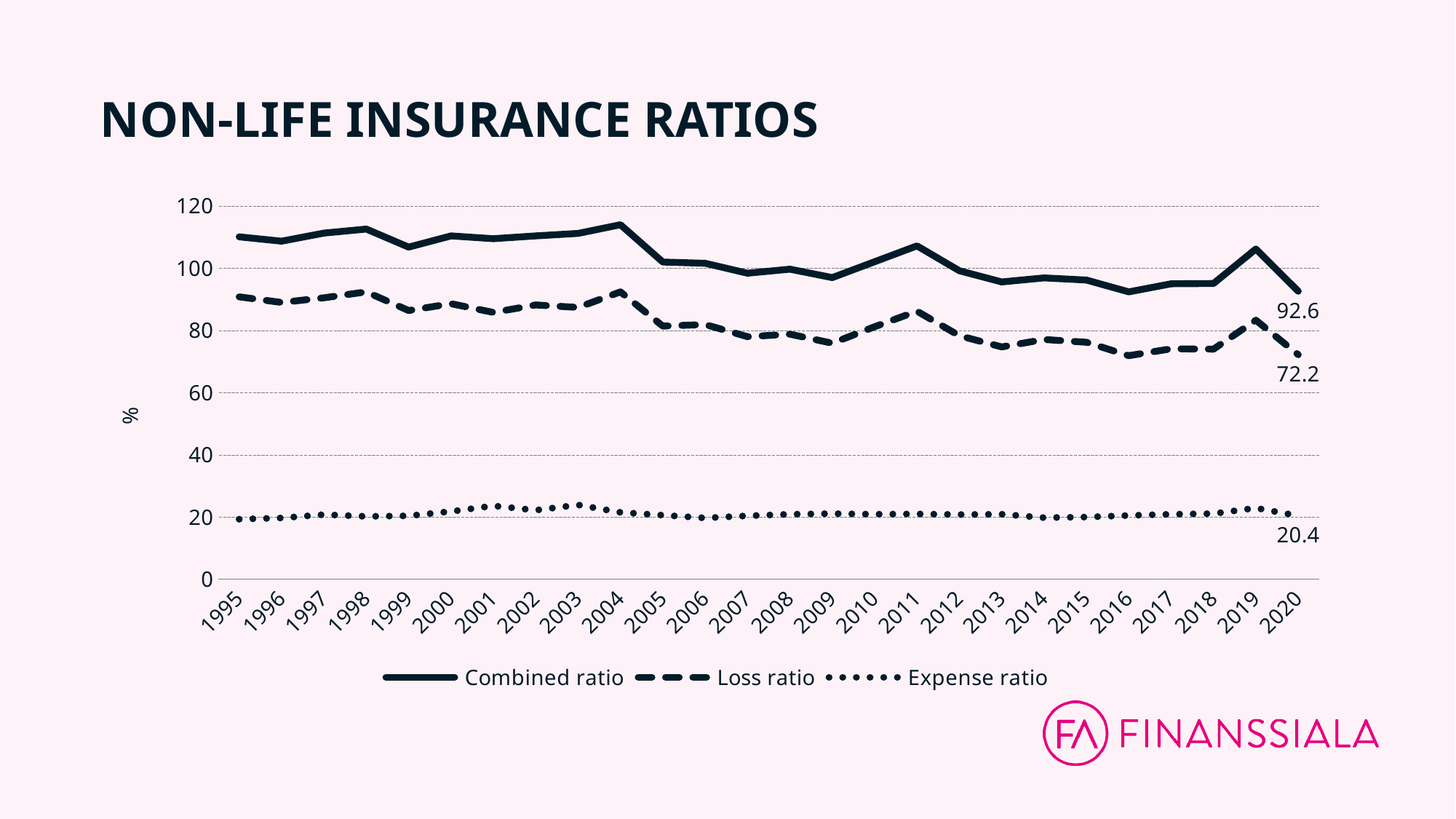
Is the Loss ratio for 2016 greater or less than 80? less What is the difference between the Combined ratio and the Loss ratio in 2020? 20.4 How many years are shown on the x axis? 26 Is the Combined ratio for 2004 greater or less than 100? greater Which series has the highest value in 2020? Combined ratio What is the Loss ratio value shown for 2020? 72.2 What is the Expense ratio value shown for 2020? 20.4 In 2020, which is larger: the Loss ratio or the Expense ratio? Loss ratio How many series does the legend list? 3 What is the Combined ratio value shown for 2020? 92.6 Is the Expense ratio for 2003 greater or less than 40? less What kind of chart is shown on the slide? Line chart